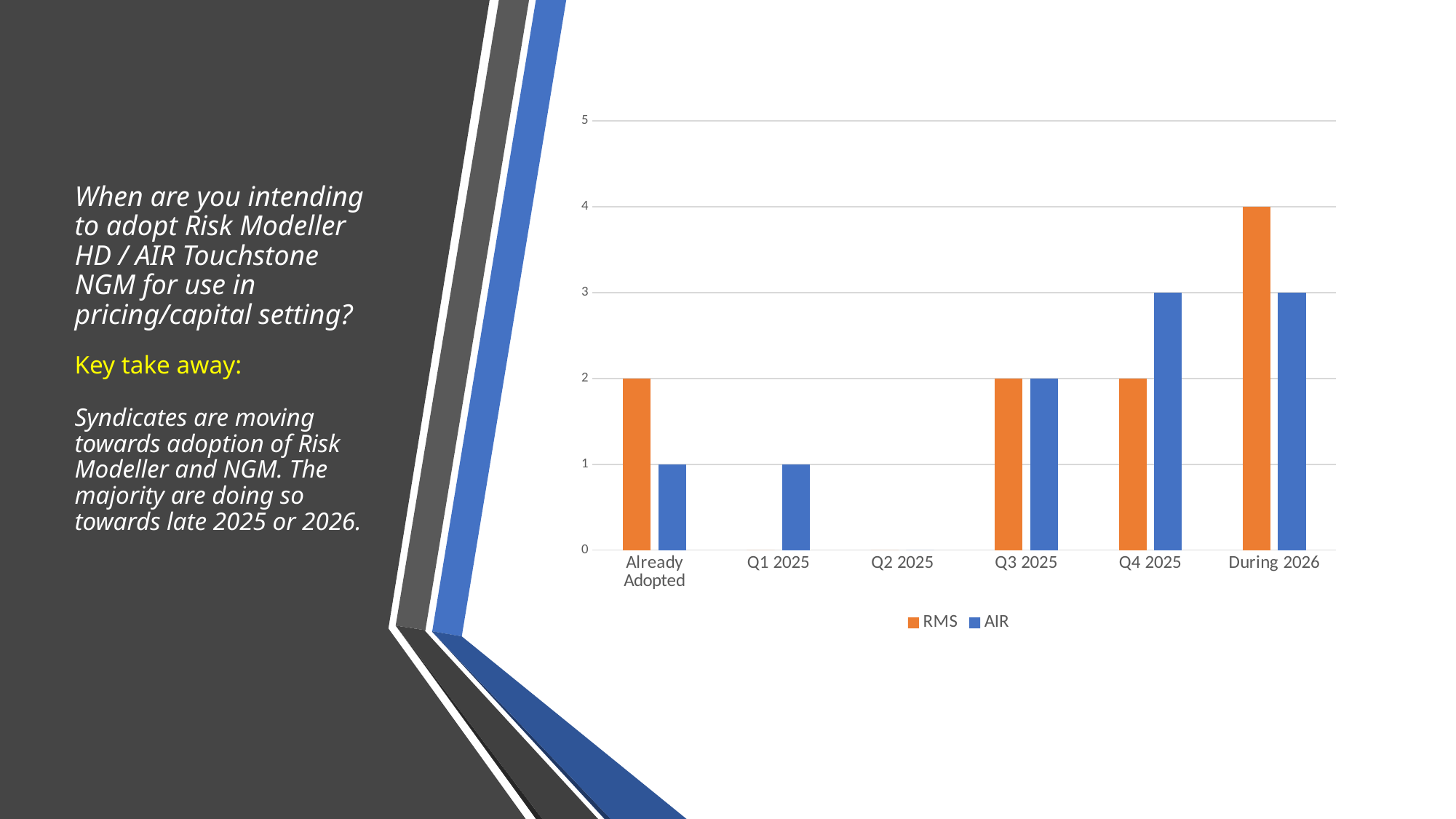
What is the AIR value for Q4 2025? 3 What kind of chart is shown on the slide? bar chart Which category has the highest RMS value? During 2026 What is the difference between the RMS and AIR values for Already Adopted? 1 How many series does the legend list? 2 Is the RMS value for During 2026 greater or less than 3? greater Which is larger for Q4 2025, the RMS value or the AIR value? AIR What is the AIR value for Q1 2025? 1 How many categories are shown on the x axis? 6 What is the RMS value for Already Adopted? 2 What is the RMS value for During 2026? 4 Which colour represents the AIR series in the legend? blue